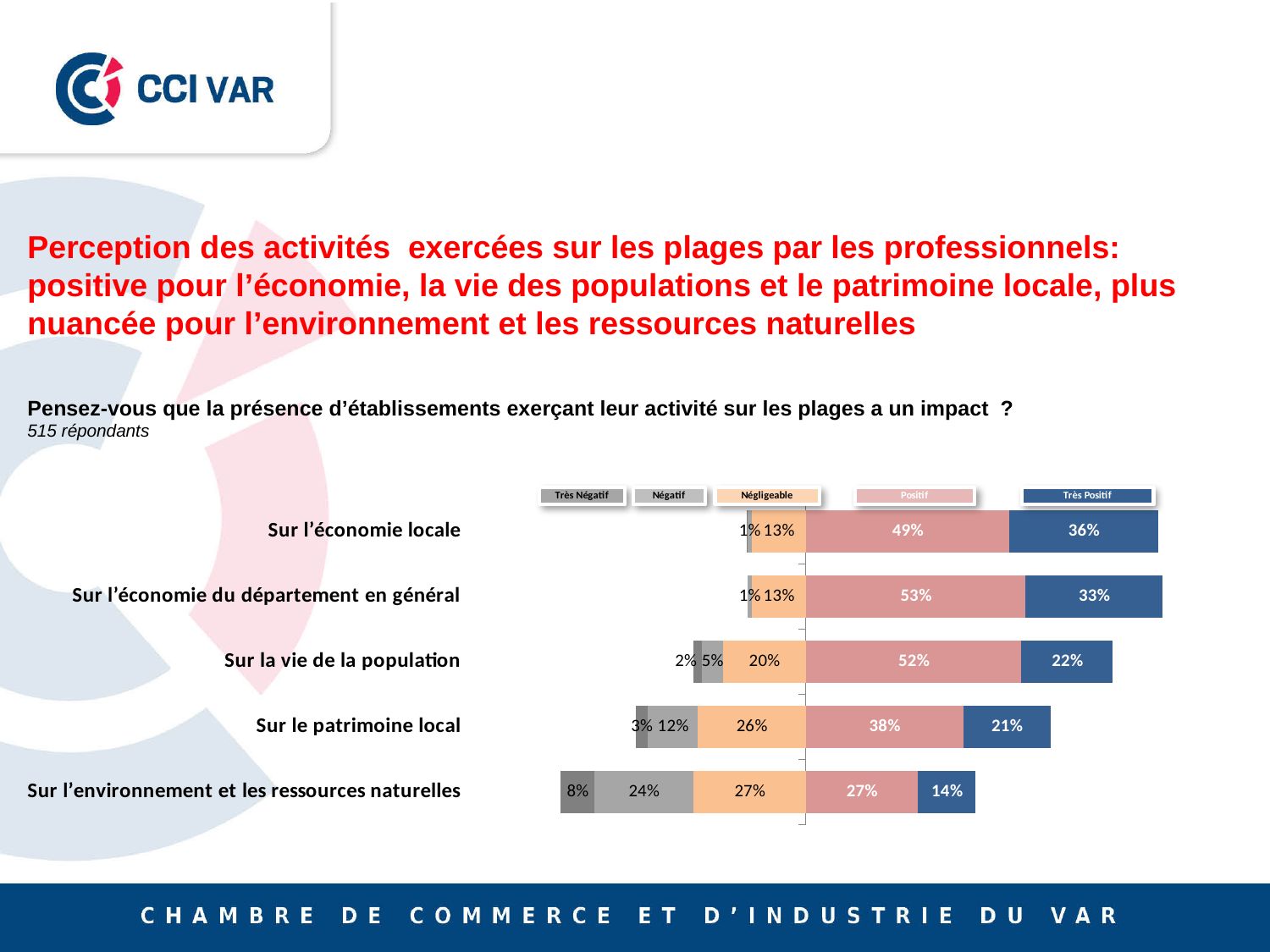
Which category has the lowest Très Positif value? Sur l’environnement et les ressources naturelles How many series does the legend list? 5 Which category has the highest Positif value? Sur l’économie du département en général What is the difference between the Très Positif values for "Sur l’économie locale" and "Sur l’économie du département en général"? 3 percentage points What is the Très Positif value for "Sur l’économie du département en général"? 33% What is the Très Négatif value for "Sur l’environnement et les ressources naturelles"? 8% Which has the larger Positif value: "Sur la vie de la population" or "Sur le patrimoine local"? Sur la vie de la population What is the Négligeable value for "Sur le patrimoine local"? 26% How many categories (impact areas) are shown in the chart? 5 What is the difference between the Négatif values for "Sur l’environnement et les ressources naturelles" and "Sur le patrimoine local"? 12 percentage points What kind of chart is shown on the slide? Stacked bar chart What is the value of the Positif segment for "Sur l’économie locale"? 49%